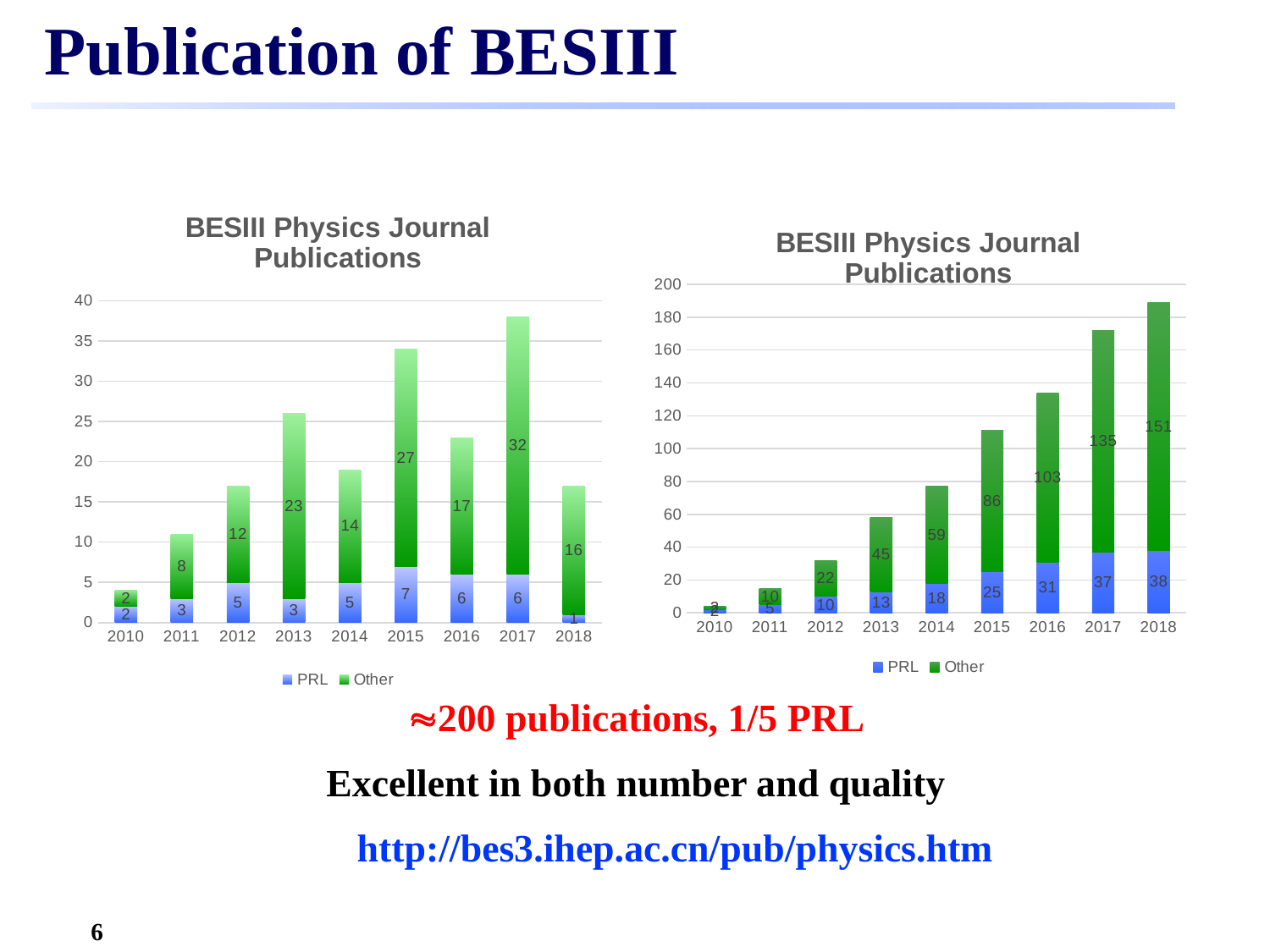
In the right chart, is the total stacked bar for 2018 greater or less than 180? greater In the left chart, what is the Other value for 2017? 32 In the left chart, what is the total of the stacked bar for 2015? 34 How many series does the legend of the right chart list? 2 In the left chart, is the Other value for 2013 larger than the Other value for 2014? Yes In the right chart, what is the PRL value for 2016? 31 In the right chart, what is the difference between the Other values for 2018 and 2017? 16 In the right chart, what is the Other value for 2018? 151 In the right chart, which year has the lowest PRL value? 2010 In the left chart, which year has the highest Other value? 2017 What kind of chart is the left chart? Stacked bar chart In the left chart, what is the PRL value for 2015? 7